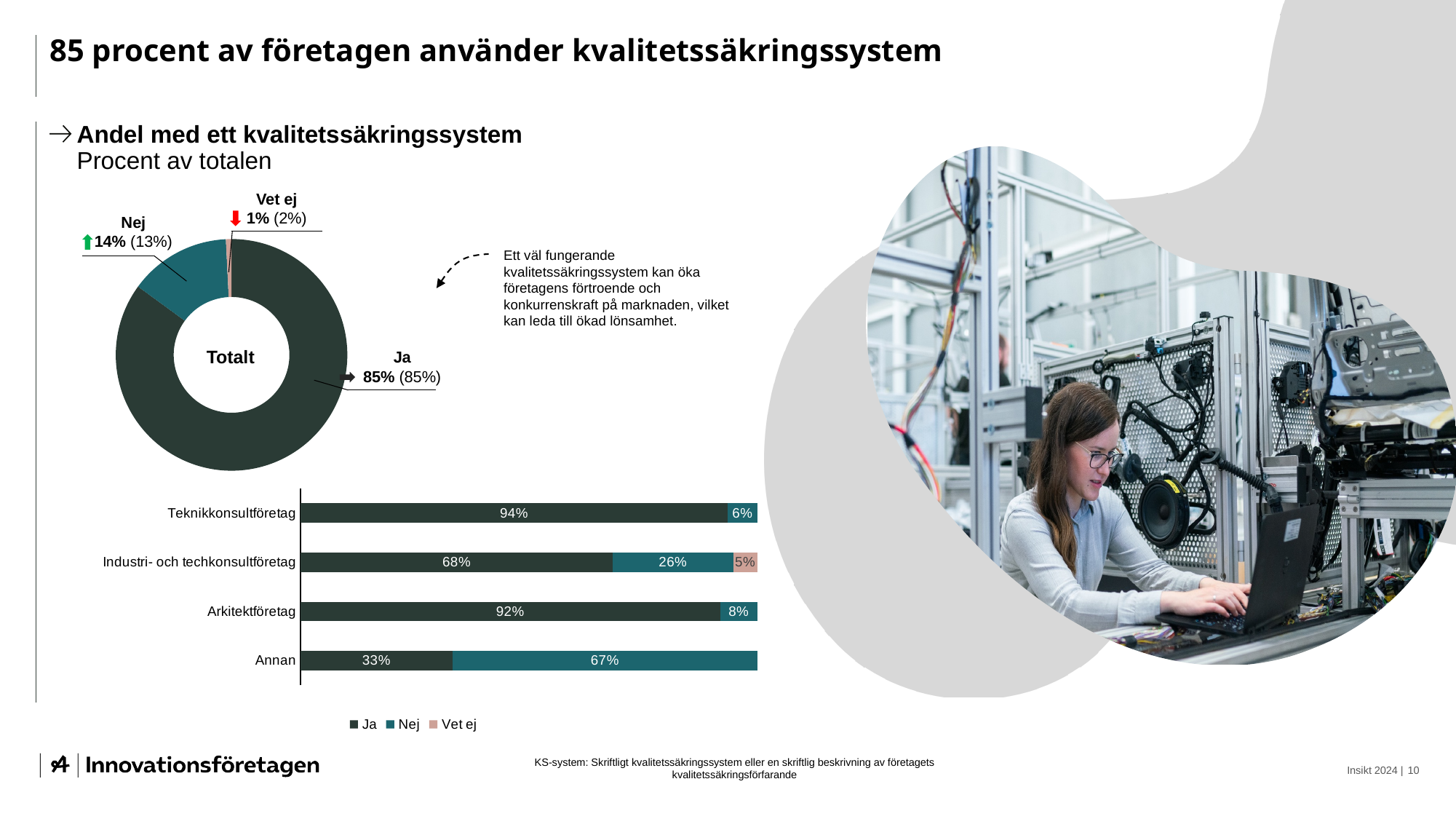
In the bar chart, which is larger: the "Nej" value for Annan or the "Nej" value for Arkitektföretag? Annan How many categories are shown in the bar chart? 4 In the bar chart, what is the "Ja" value for Teknikkonsultföretag? 94% In the bar chart, which category has the lowest "Ja" value? Annan How many series does the bar chart legend list? 3 In the donut chart, what is the value for "Nej"? 14% In the bar chart, what is the "Vet ej" value for Industri- och techkonsultföretag? 5% In the donut chart, what is the value for "Vet ej"? 1% In the donut chart, which category has the largest slice? Ja In the bar chart, what is the difference between the "Ja" values for Teknikkonsultföretag and Arkitektföretag? 2% In the bar chart, what is the "Nej" value for Industri- och techkonsultföretag? 26% In the donut chart, what share of the total answered "Ja"? 85%